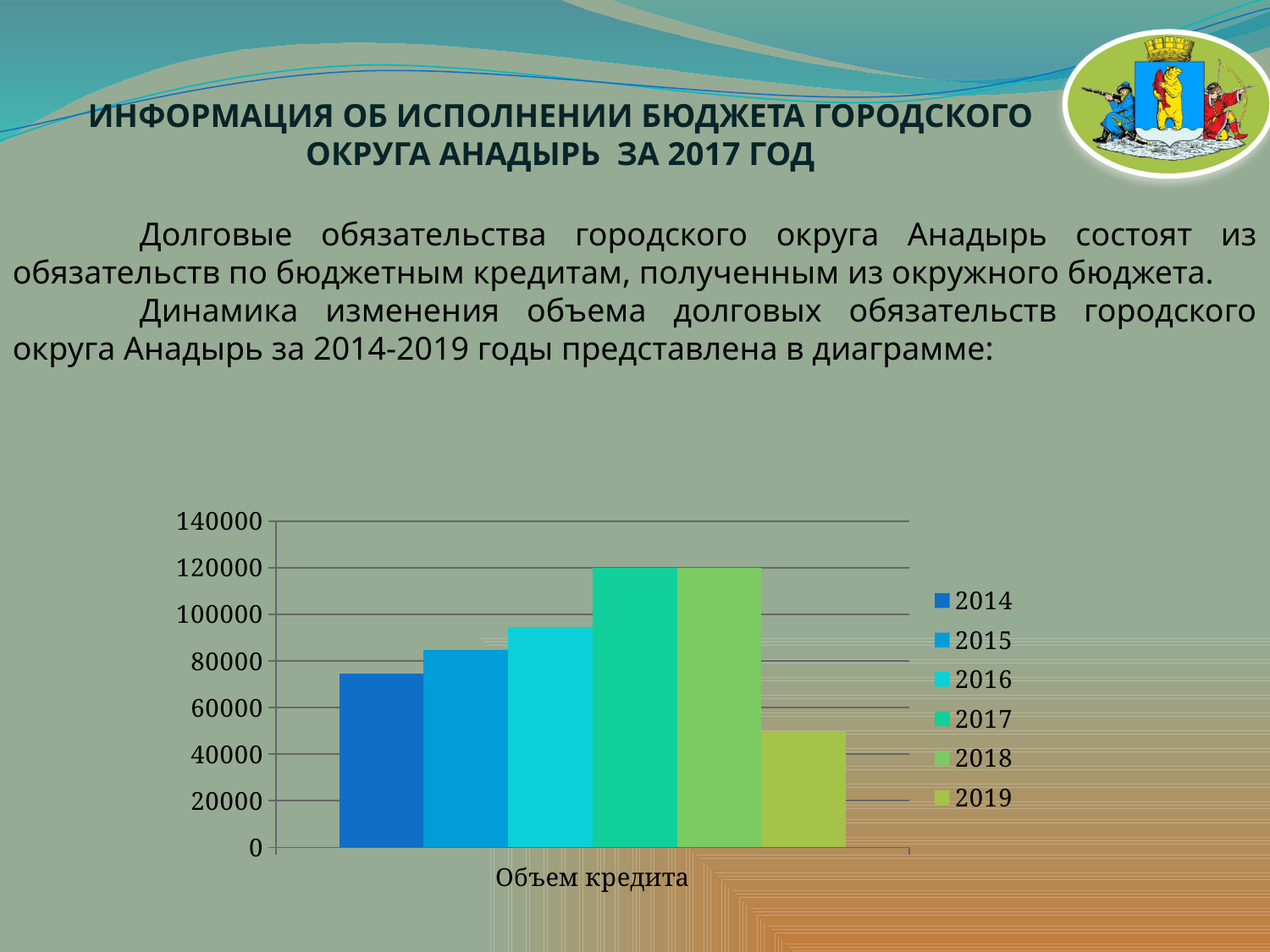
What kind of chart is shown on the slide? bar chart Is the value for 2014 greater or less than 80000? less Is the value for 2017 greater or less than 100000? greater Which year has the lowest value for Объем кредита? 2019 Is the value for 2019 greater or less than 60000? less How many categories are shown on the x axis? 1 Which is larger, the value for 2015 or the value for 2014? 2015 What is the category label shown on the x axis? Объем кредита Which is larger, the value for 2019 or the value for 2016? 2016 How many series does the legend list? 6